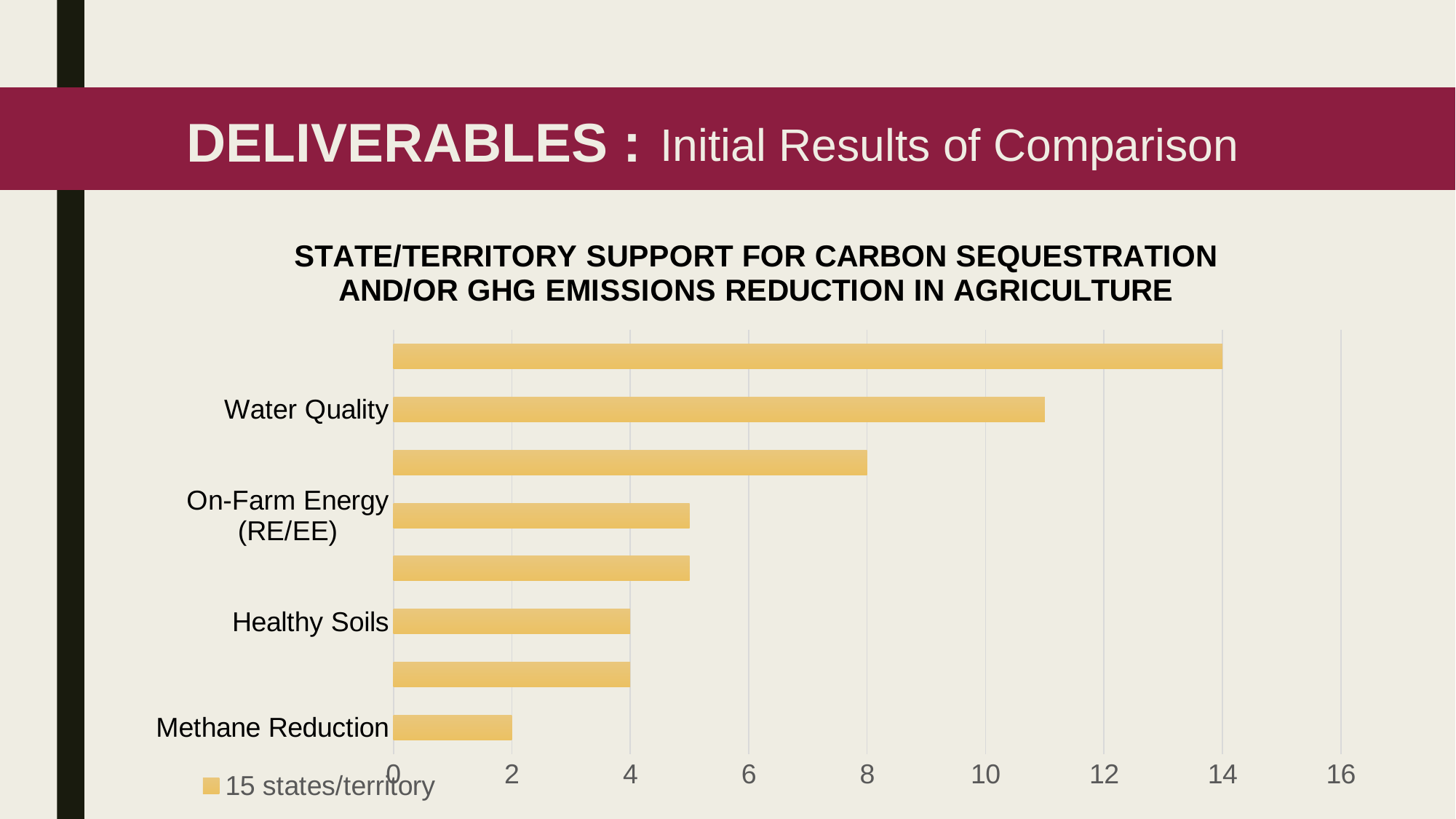
Is the value for Water Quality greater or less than 10? greater What is the legend entry shown below the chart? 15 states/territory What is the value for Methane Reduction? 2 What kind of chart is shown on the slide? bar chart What is the difference between the values for Healthy Soils and Methane Reduction? 2 How many series does the legend list? 1 Is the value for On-Farm Energy (RE/EE) greater or less than 6? less What is the value for Healthy Soils? 4 Which category has the lowest value in the chart? Methane Reduction Is the value for On-Farm Energy (RE/EE) greater or less than 4? greater Which is larger, the value for Water Quality or the value for Healthy Soils? Water Quality